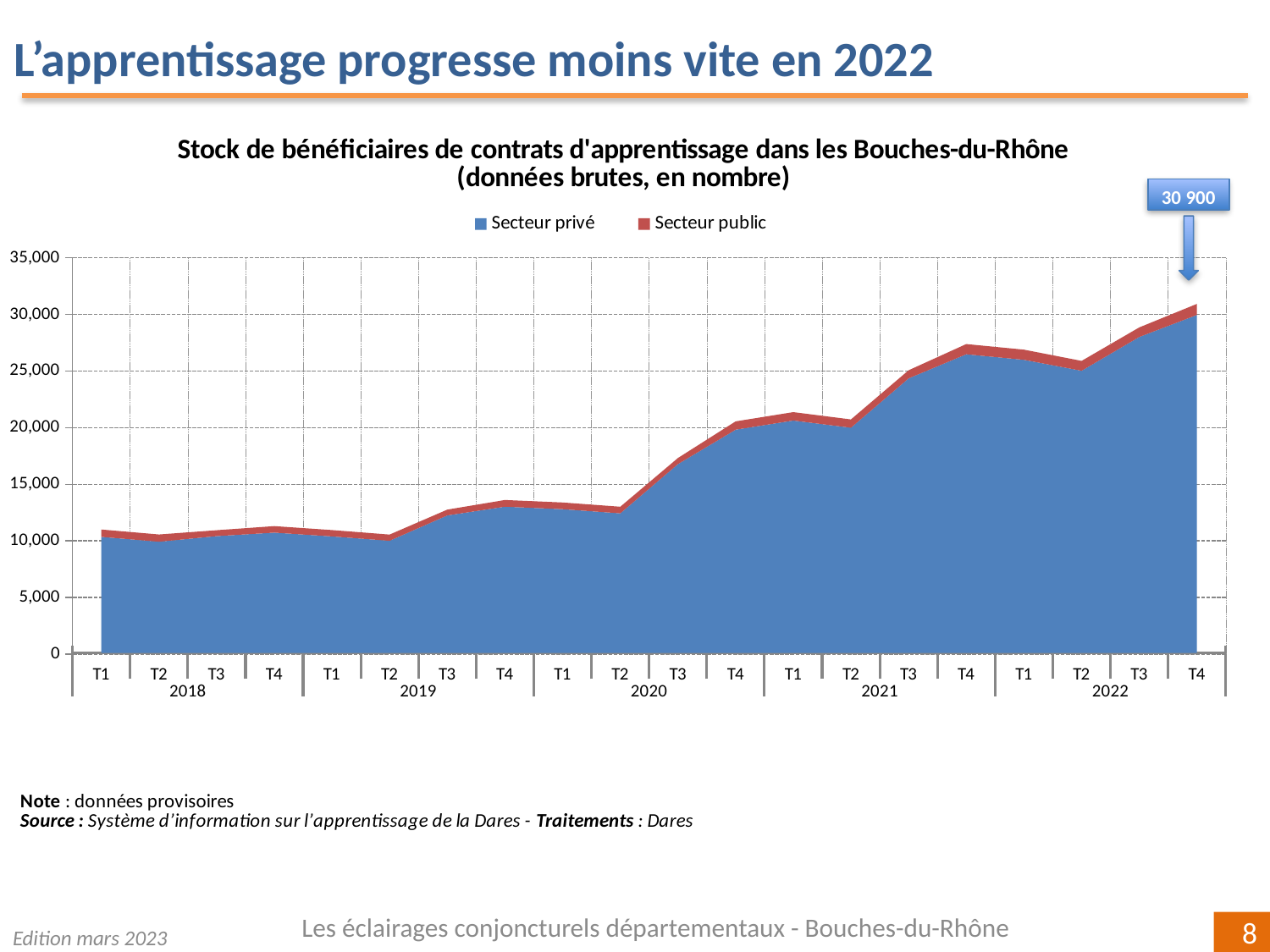
How many series does the legend list? 2 Is the total value for T2 2020 greater or less than 15,000? less How many quarterly points are plotted along the x axis? 20 Which is larger, the total for T4 2020 or the total for T4 2018? T4 2020 Is the total value for T4 2021 greater or less than 25,000? greater What are the two series named in the legend? Secteur privé and Secteur public Do the values generally rise or fall from T1 2018 to T4 2022? rise What kind of chart is shown on the slide? Area chart Which series accounts for the larger part of the stacked total, Secteur privé or Secteur public? Secteur privé What total value is called out for T4 2022? 30 900 Is the total value for T1 2018 greater or less than 15,000? less In which quarter is the total stock of apprenticeship contracts highest? T4 2022